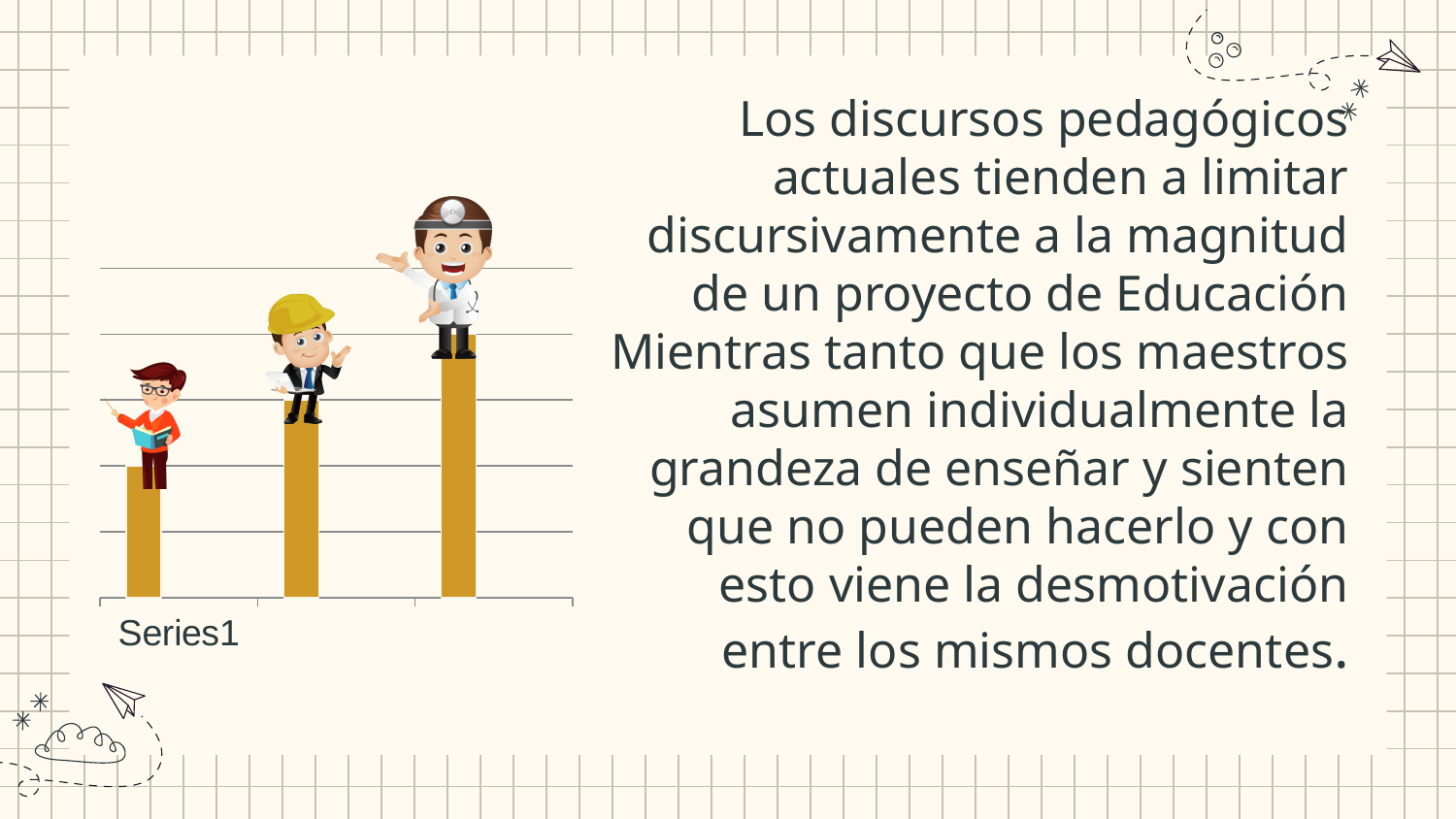
How many bars does the chart contain? 3 What colour are the bars in the chart? gold/orange-yellow Which is larger, the value of the middle bar or the value of the rightmost bar? rightmost bar Which bar in the chart is the shortest: the left, middle, or right one? left Which is larger, the value of the leftmost bar or the value of the middle bar? middle bar Which bar in the chart is the tallest: the left, middle, or right one? right How many series does the chart's legend list? 1 Do the bar values rise or fall from left to right across the chart? rise What kind of chart is shown on the left of the slide? bar chart What is the name of the series shown in the chart's legend? Series1